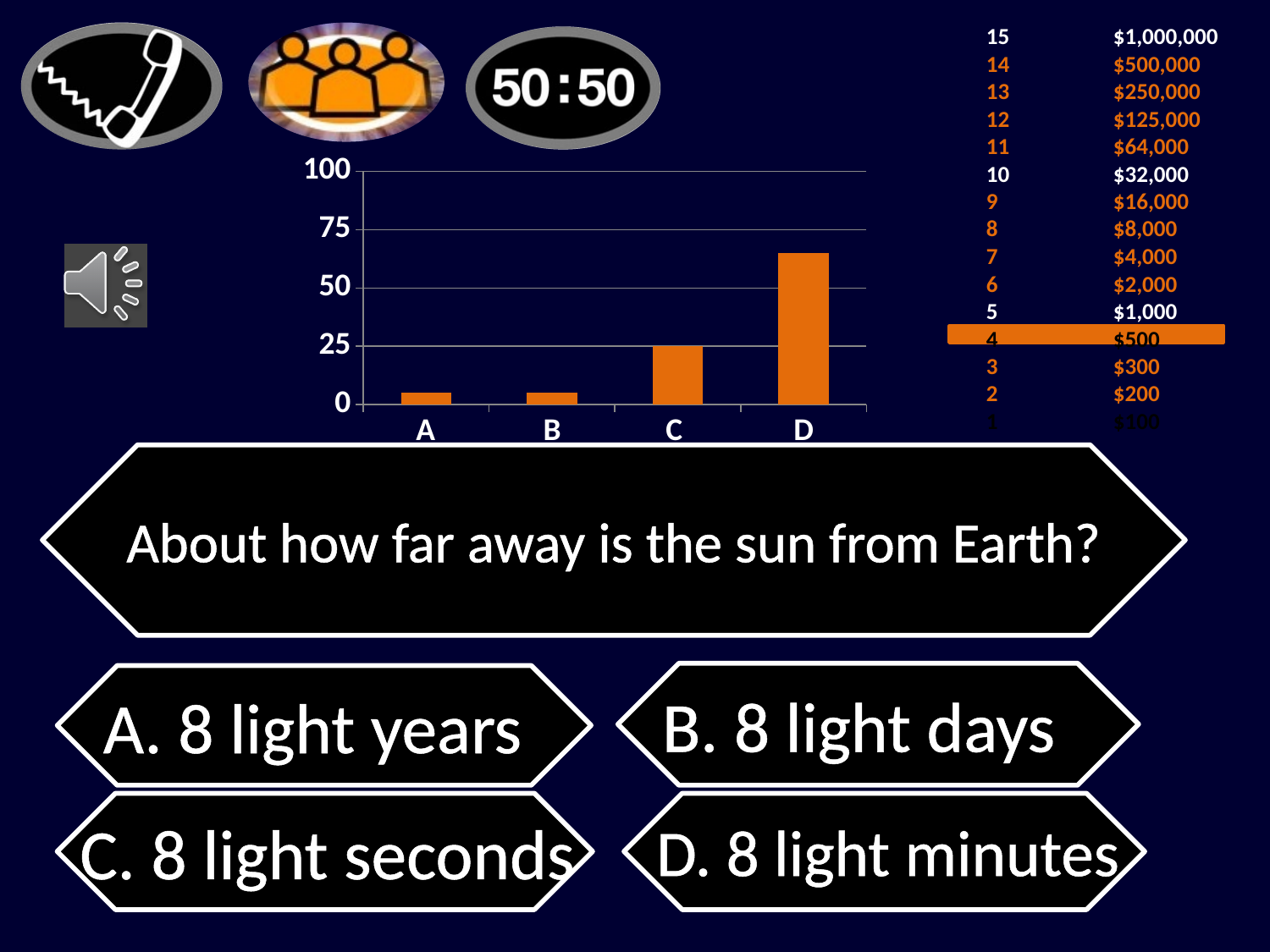
Which category has the highest bar in the chart? D Which is larger, the value for A or the value for C? C Is the value for D greater or less than 50? greater Is the value for B greater or less than 25? less Is the value for A greater or less than 25? less What kind of chart is shown on the slide? bar chart How many categories are shown on the x axis of the chart? 4 Which is larger, the value for C or the value for D? D What is the value for category C in the chart? 25 What is the highest value labelled on the chart's vertical axis? 100 Do the bar values generally rise or fall from A to D along the x axis? rise